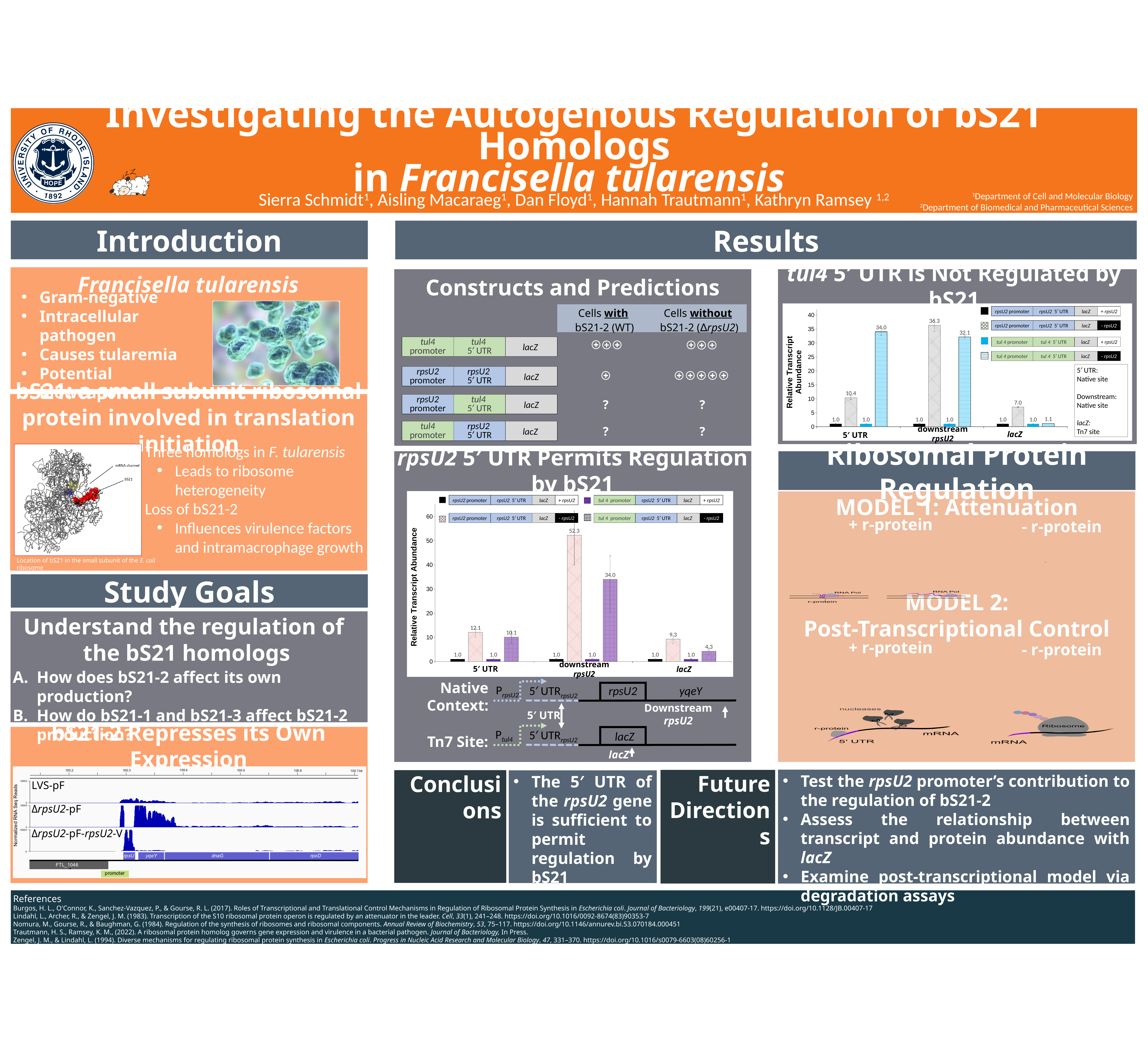
In the chart titled "rpsU2 5′ UTR Permits Regulation by bS21", what is the value of the tallest bar in the "5′ UTR" category? 12.1 In the chart titled "rpsU2 5′ UTR Permits Regulation by bS21", what is the value of the tallest bar in the "lacZ" category? 9.3 In the chart titled "rpsU2 5′ UTR Permits Regulation by bS21", what is the difference between the two largest labelled values in the "downstream rpsU2" category (52.3 and 34.0)? 18.3 In the chart titled "tul4 5′ UTR is Not Regulated by bS21", what is the value of the tallest bar in the "lacZ" category? 7.0 In the chart titled "rpsU2 5′ UTR Permits Regulation by bS21", what is the highest value labelled in the "downstream rpsU2" category? 52.3 In the chart titled "tul4 5′ UTR is Not Regulated by bS21", what is the highest value labelled in the "downstream rpsU2" category? 36.3 What kind of chart is the one titled "rpsU2 5′ UTR Permits Regulation by bS21"? bar chart In the chart titled "rpsU2 5′ UTR Permits Regulation by bS21", how many categories are shown on the x axis? 3 In the chart titled "tul4 5′ UTR is Not Regulated by bS21", which is larger: the tallest bar in the "5′ UTR" category or the tallest bar in the "lacZ" category? 5′ UTR In the chart titled "rpsU2 5′ UTR Permits Regulation by bS21", how many series does the legend list? 4 In the chart titled "tul4 5′ UTR is Not Regulated by bS21", what is the value of the tallest bar in the "5′ UTR" category? 34.0 In the chart titled "tul4 5′ UTR is Not Regulated by bS21", what is the label on the y axis? Relative Transcript Abundance